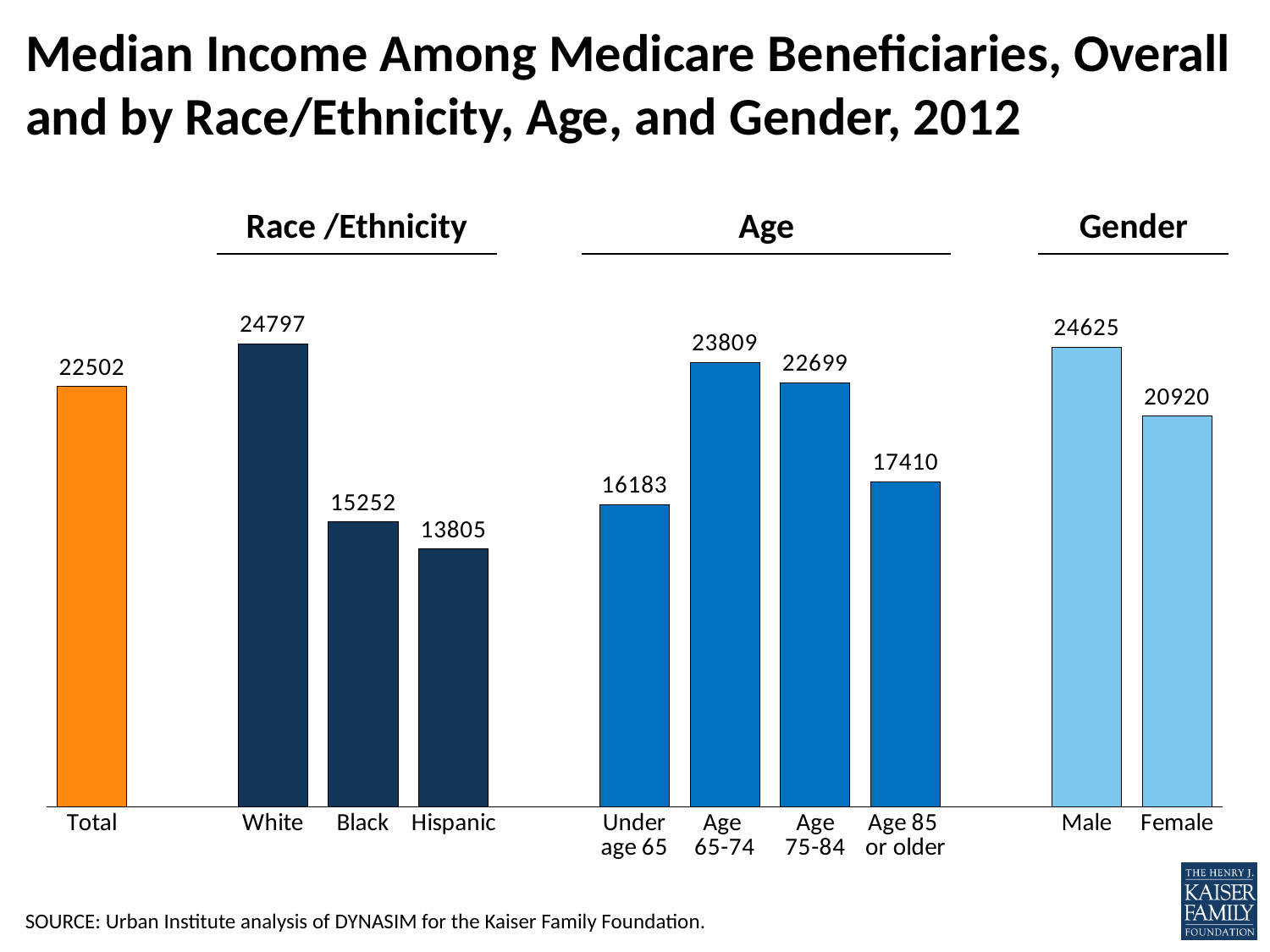
What is the difference between the median income for White and Black beneficiaries? 9545 Which category has the lowest median income on the chart? Hispanic What is the median income shown for beneficiaries Age 85 or older? 17410 What kind of chart is shown on the slide? Bar chart What is the median income shown for Hispanic beneficiaries? 13805 Which has a higher median income, Age 65-74 or Age 75-84? Age 65-74 Which category has the highest median income on the chart? White What is the median income shown for Total? 22502 What is the median income shown for Female beneficiaries? 20920 What are the three group headings shown above the bars? Race/Ethnicity, Age, Gender How many bars are plotted on the chart? 10 What is the difference between the median income for Male and Female beneficiaries? 3705